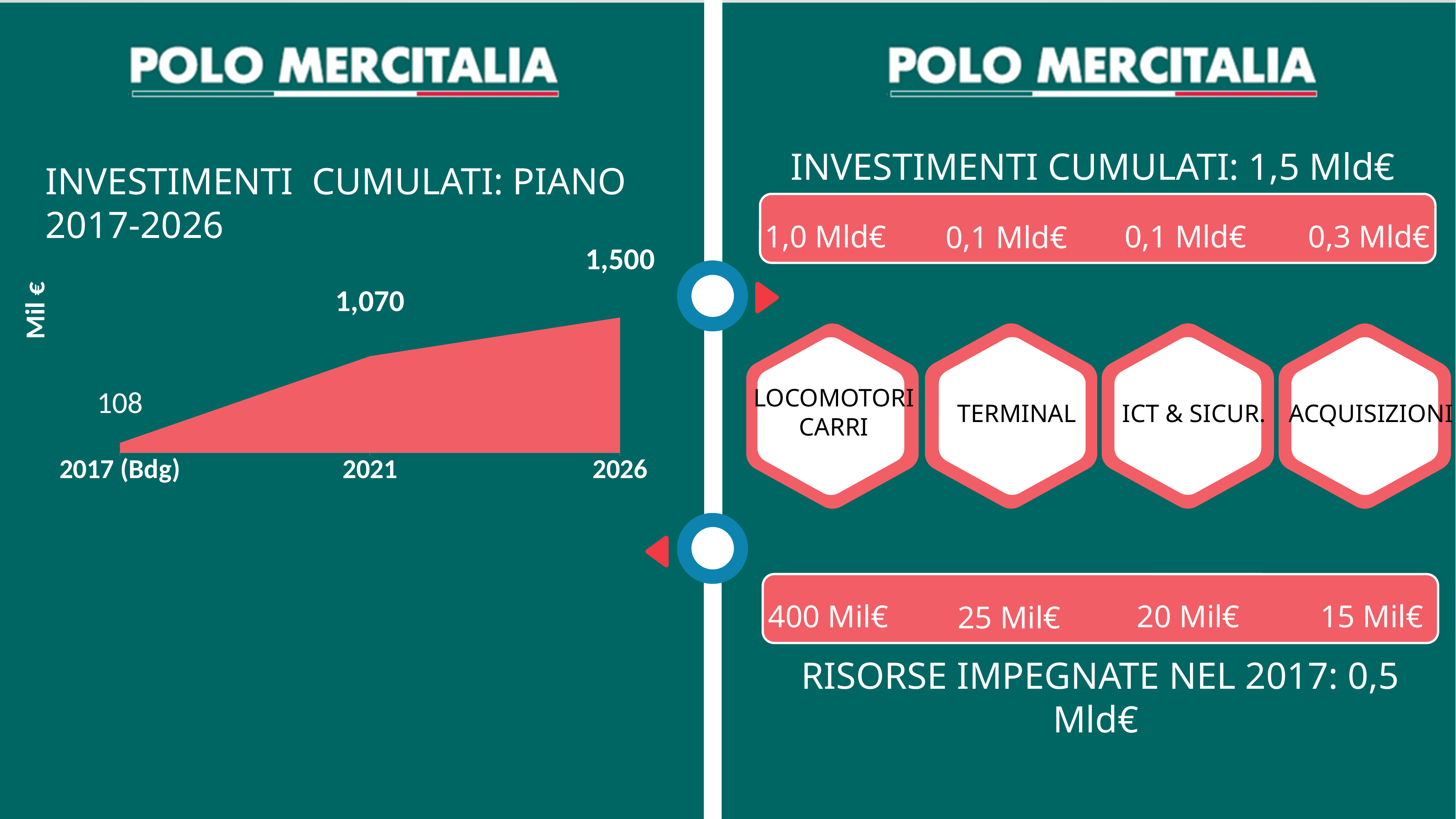
Which year has the highest cumulative investment value in the chart? 2026 What is the difference between the values for 2026 and 2021? 430 Which is larger, the value for 2021 or the value for 2026? 2026 What is the cumulative investment value shown for 2017 (Bdg)? 108 Which year has the lowest cumulative investment value in the chart? 2017 (Bdg) What is the difference between the values for 2021 and 2017 (Bdg)? 962 Do the values rise or fall from 2017 (Bdg) to 2026? Rise What unit label is shown on the vertical axis of the chart? Mil € What is the cumulative investment value shown for 2026? 1,500 What is the cumulative investment value shown for 2021? 1,070 What kind of chart is shown on the slide? Area chart How many data points are plotted in the chart? 3